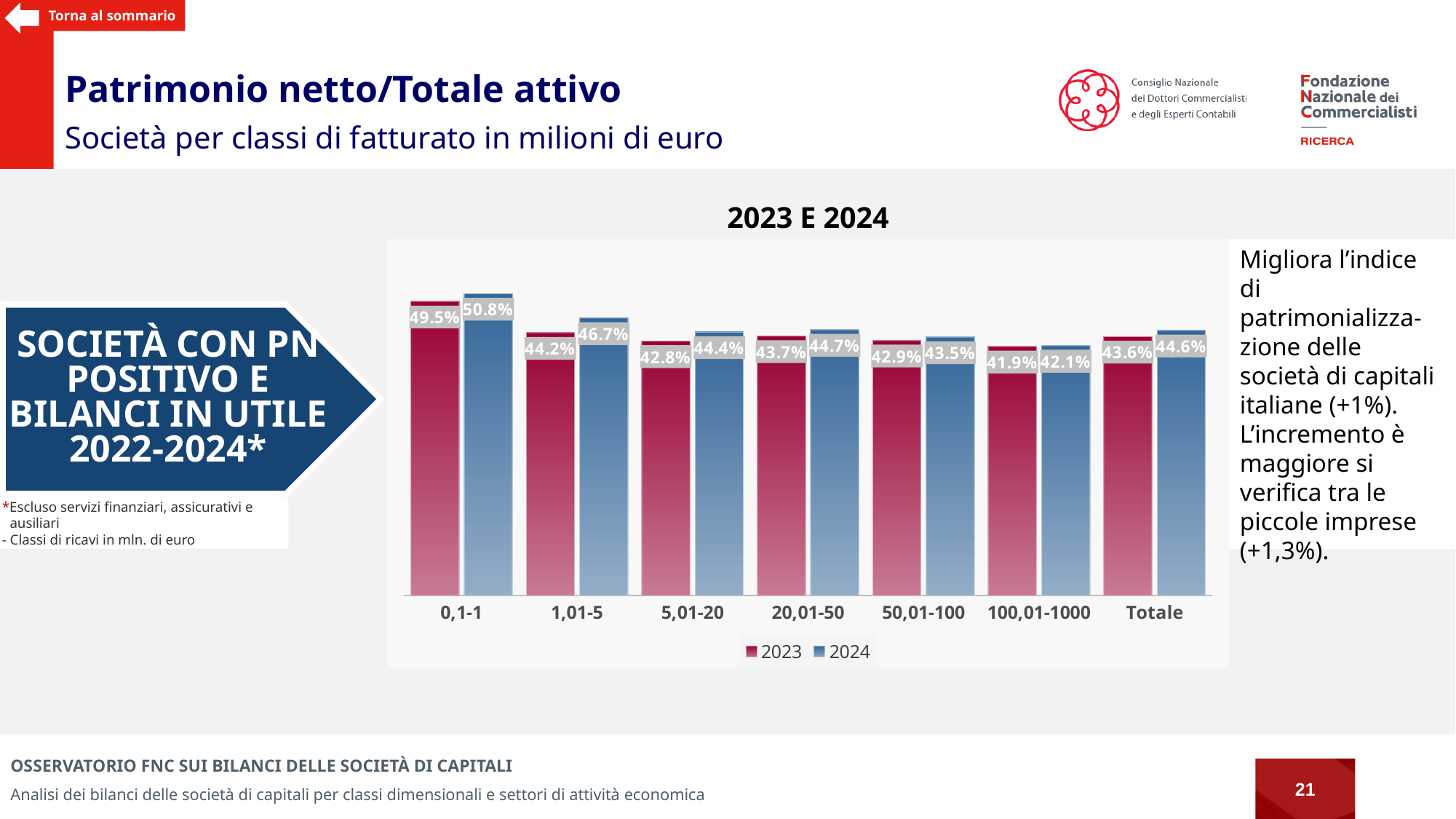
What is the difference between the 2024 and 2023 values for the 1,01-5 class? 2.5 percentage points Which is larger for the 5,01-20 class: the 2023 value or the 2024 value? 2024 What is the 2024 value for the 1,01-5 revenue class? 46.7% Which revenue class has the lowest 2023 value? 100,01-1000 Which revenue class has the highest 2024 value? 0,1-1 What is the difference between the 2024 and 2023 values for the 0,1-1 class? 1.3 percentage points What is the title shown above the chart? 2023 E 2024 How many revenue classes (categories) are shown on the x axis? 7 What kind of chart is shown on the slide? Bar chart How many series does the legend list? 2 What is the 2024 value for Totale? 44.6% What is the 2023 value for the 0,1-1 revenue class? 49.5%